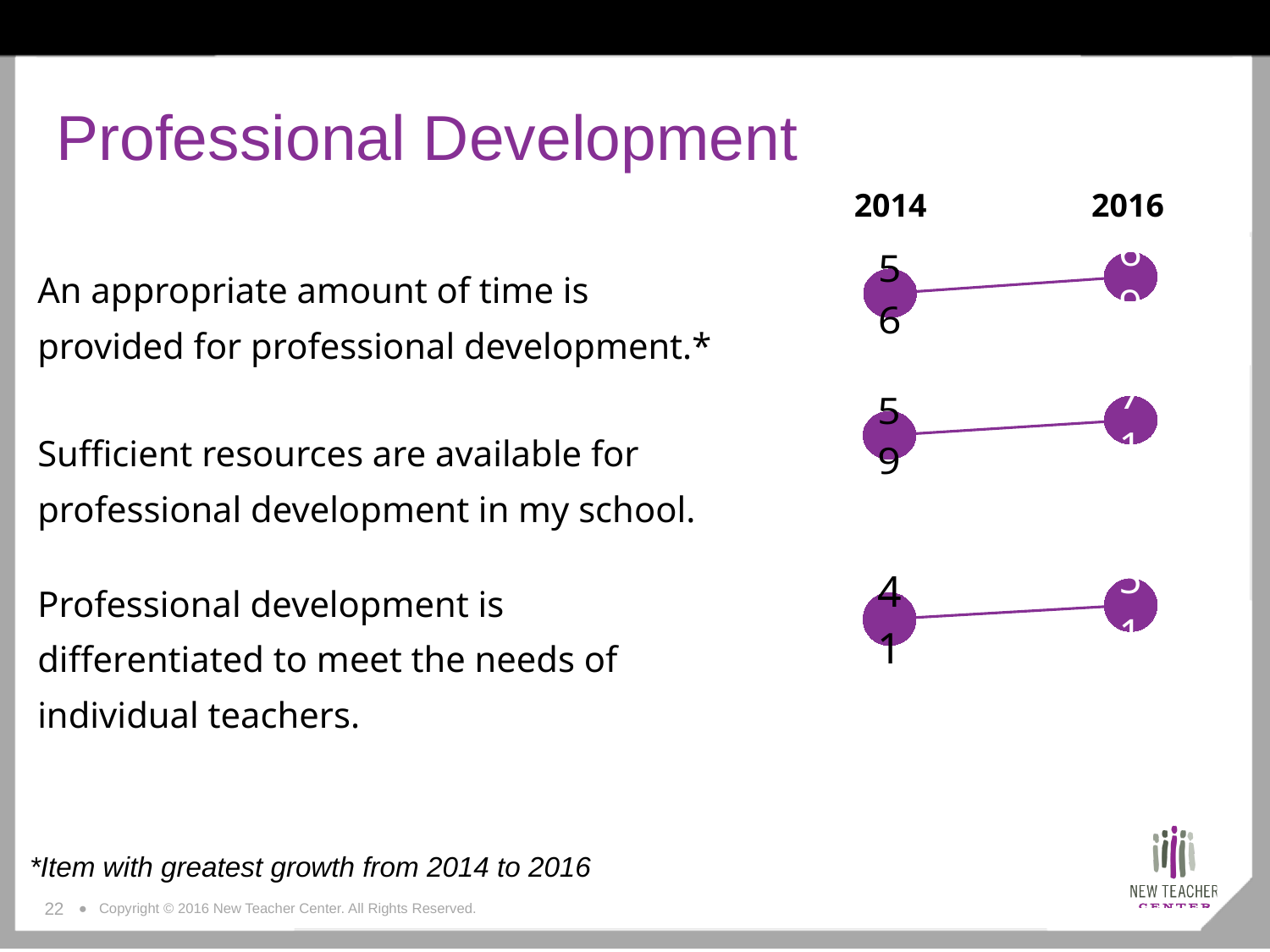
Which of the three professional development items has the highest 2014 value? Sufficient resources are available for professional development in my school In the chart next to "An appropriate amount of time is provided for professional development", does the value rise or fall from 2014 to 2016? rise What is the difference between the 2014 values for "Sufficient resources are available" and "Professional development is differentiated"? 18 Which two years are compared in the charts on the slide? 2014 and 2016 In the chart next to "Sufficient resources are available for professional development in my school", what is the 2014 value? 59 What is the difference between the 2014 values for "Sufficient resources are available" and "An appropriate amount of time is provided"? 3 In the chart next to "An appropriate amount of time is provided for professional development", what is the 2014 value? 56 Which of the three professional development items has the lowest 2014 value? Professional development is differentiated to meet the needs of individual teachers In the chart next to "Professional development is differentiated to meet the needs of individual teachers", what is the 2014 value? 41 In the chart next to "Professional development is differentiated to meet the needs of individual teachers", does the value rise or fall from 2014 to 2016? rise How many small charts are shown on the slide? 3 Which has the larger 2014 value: "An appropriate amount of time is provided" or "Sufficient resources are available"? Sufficient resources are available